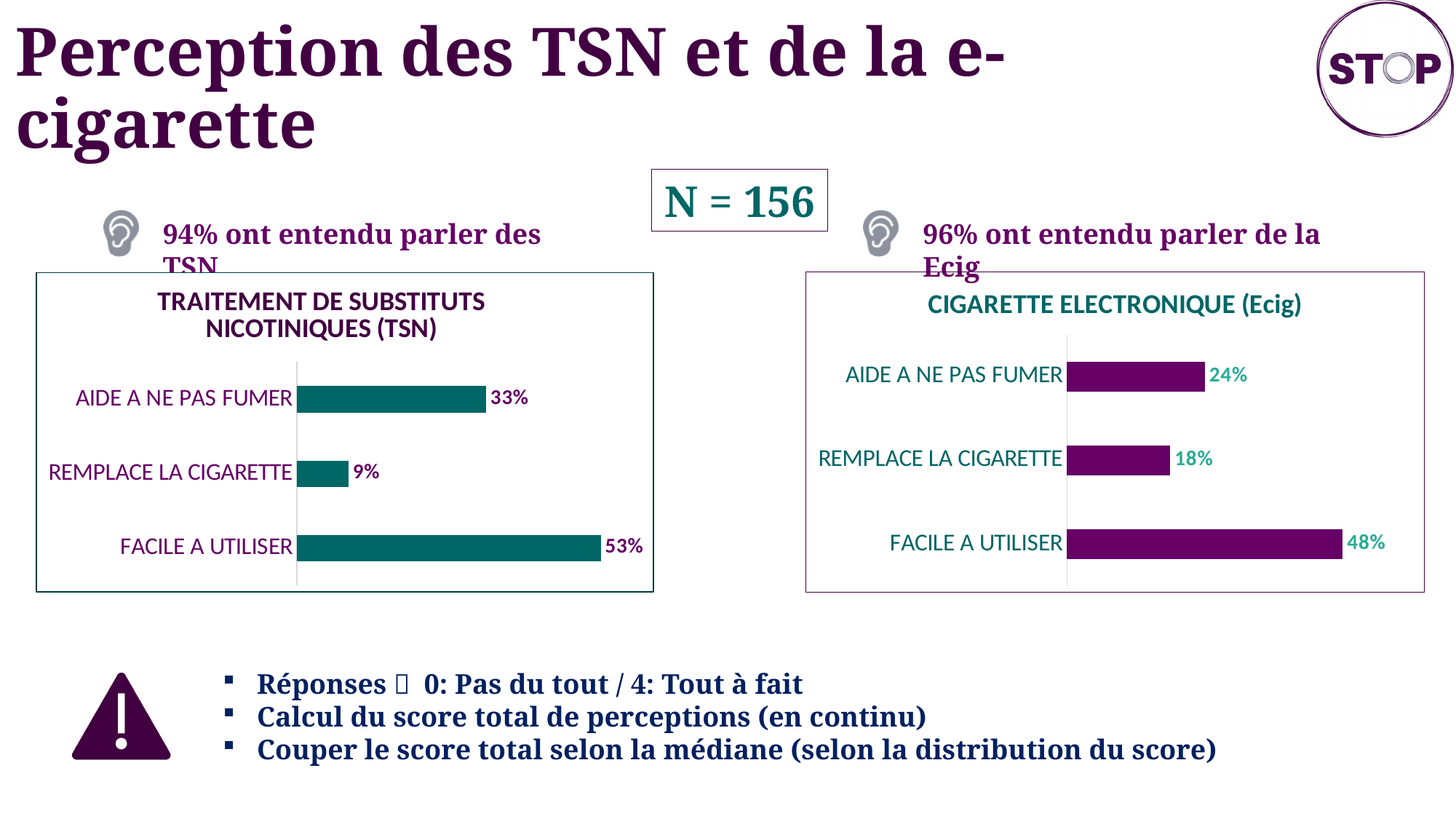
What type of chart is the TSN chart (left)? Bar chart In the TSN chart (left), what is the value for FACILE A UTILISER? 53% In the TSN chart (left), what is the difference between AIDE A NE PAS FUMER and REMPLACE LA CIGARETTE? 24% In the TSN chart (left), what is the value for REMPLACE LA CIGARETTE? 9% In the TSN chart (left), which category has the highest value? FACILE A UTILISER What is the title of the chart on the right? CIGARETTE ELECTRONIQUE (Ecig) Which is larger: FACILE A UTILISER in the TSN chart or FACILE A UTILISER in the Ecig chart? TSN chart (53%) In the Ecig chart (right), which category has the lowest value? REMPLACE LA CIGARETTE In the Ecig chart (right), what is the value for AIDE A NE PAS FUMER? 24% In the Ecig chart (right), what is the difference between FACILE A UTILISER and AIDE A NE PAS FUMER? 24% How many categories does the Ecig chart (right) show? 3 In the Ecig chart (right), what is the value for REMPLACE LA CIGARETTE? 18%